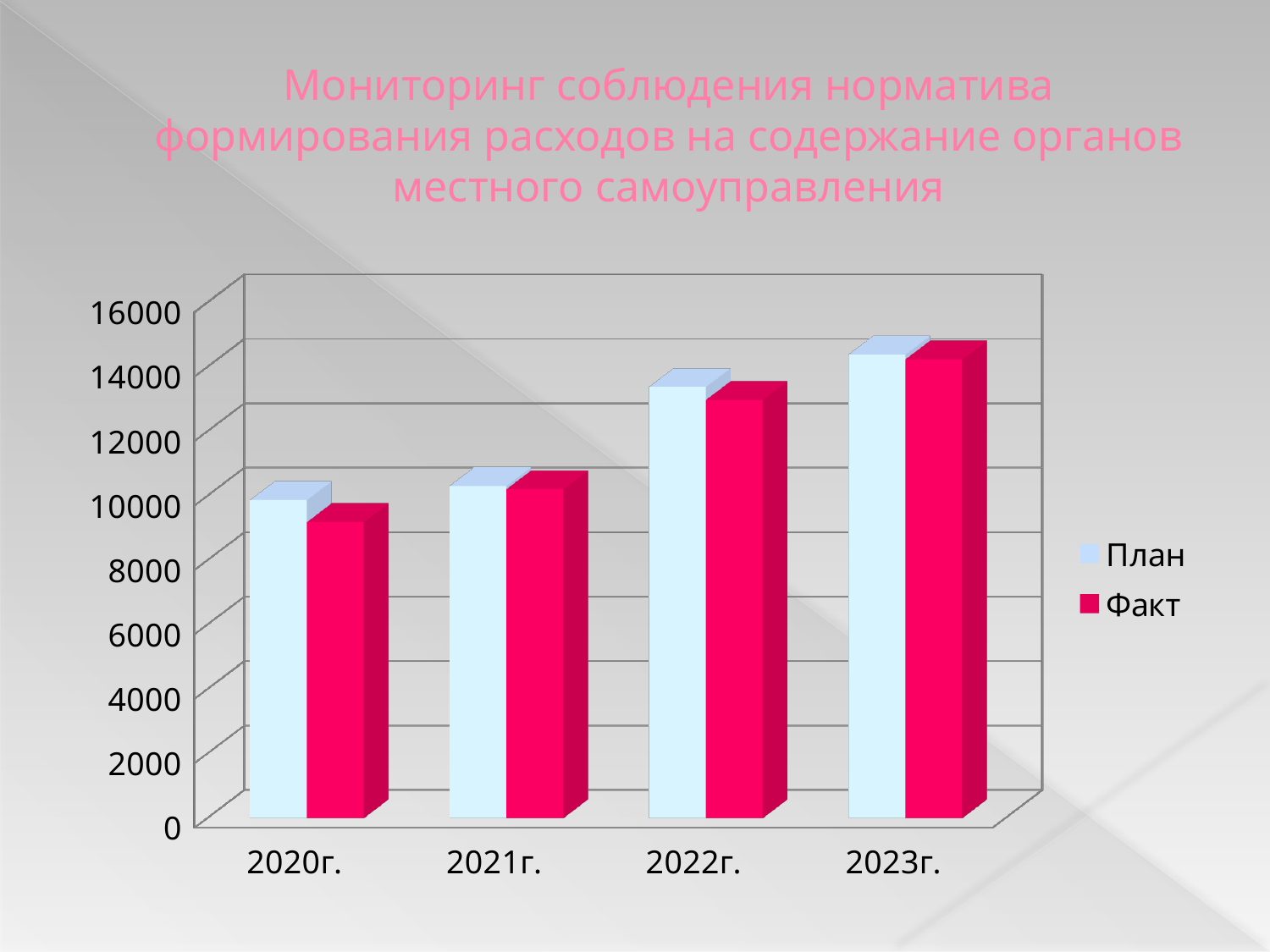
Which series is shown in red? Факт Which year has the lowest Факт value? 2020г. Is the Факт value for 2020г. greater or less than 10000? less Is the Факт value for 2022г. greater or less than 12000? greater How many years are shown on the x axis? 4 For 2020г., which is larger, План or Факт? План How many series does the legend list? 2 What kind of chart is shown on the slide? bar chart Do the План values rise or fall from 2020г. to 2023г.? rise Is the План value for 2021г. greater or less than 10000? greater Which year has the highest План value? 2023г.